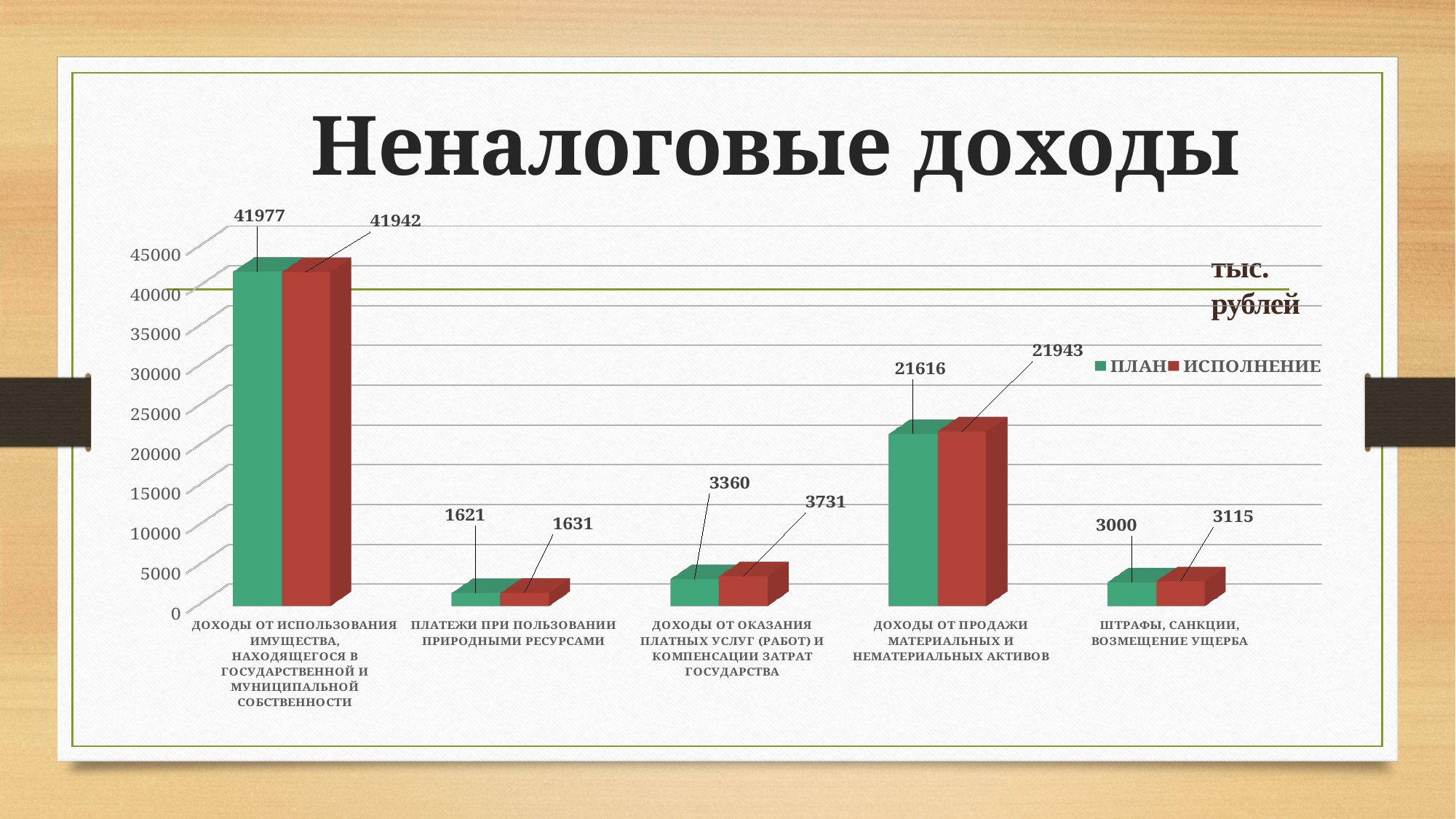
What kind of chart is shown on the slide? Bar chart What is the ПЛАН value for ДОХОДЫ ОТ ПРОДАЖИ МАТЕРИАЛЬНЫХ И НЕМАТЕРИАЛЬНЫХ АКТИВОВ? 21616 Is the ИСПОЛНЕНИЕ value for ДОХОДЫ ОТ ПРОДАЖИ МАТЕРИАЛЬНЫХ И НЕМАТЕРИАЛЬНЫХ АКТИВОВ greater or less than 20000? greater What is the ПЛАН value for ШТРАФЫ, САНКЦИИ, ВОЗМЕЩЕНИЕ УЩЕРБА? 3000 How many series does the legend list? 2 What is the ИСПОЛНЕНИЕ value for ДОХОДЫ ОТ ОКАЗАНИЯ ПЛАТНЫХ УСЛУГ (РАБОТ) И КОМПЕНСАЦИИ ЗАТРАТ ГОСУДАРСТВА? 3731 Which category has the lowest ПЛАН value? ПЛАТЕЖИ ПРИ ПОЛЬЗОВАНИИ ПРИРОДНЫМИ РЕСУРСАМИ What is the difference between the ИСПОЛНЕНИЕ and ПЛАН values for ДОХОДЫ ОТ ОКАЗАНИЯ ПЛАТНЫХ УСЛУГ (РАБОТ) И КОМПЕНСАЦИИ ЗАТРАТ ГОСУДАРСТВА? 371 How many categories are shown on the x axis? 5 What is the difference between the ИСПОЛНЕНИЕ and ПЛАН values for ДОХОДЫ ОТ ПРОДАЖИ МАТЕРИАЛЬНЫХ И НЕМАТЕРИАЛЬНЫХ АКТИВОВ? 327 For ДОХОДЫ ОТ ИСПОЛЬЗОВАНИЯ ИМУЩЕСТВА, which is larger: the ПЛАН value or the ИСПОЛНЕНИЕ value? ПЛАН Which category has the highest ИСПОЛНЕНИЕ value? ДОХОДЫ ОТ ИСПОЛЬЗОВАНИЯ ИМУЩЕСТВА, НАХОДЯЩЕГОСЯ В ГОСУДАРСТВЕННОЙ И МУНИЦИПАЛЬНОЙ СОБСТВЕННОСТИ